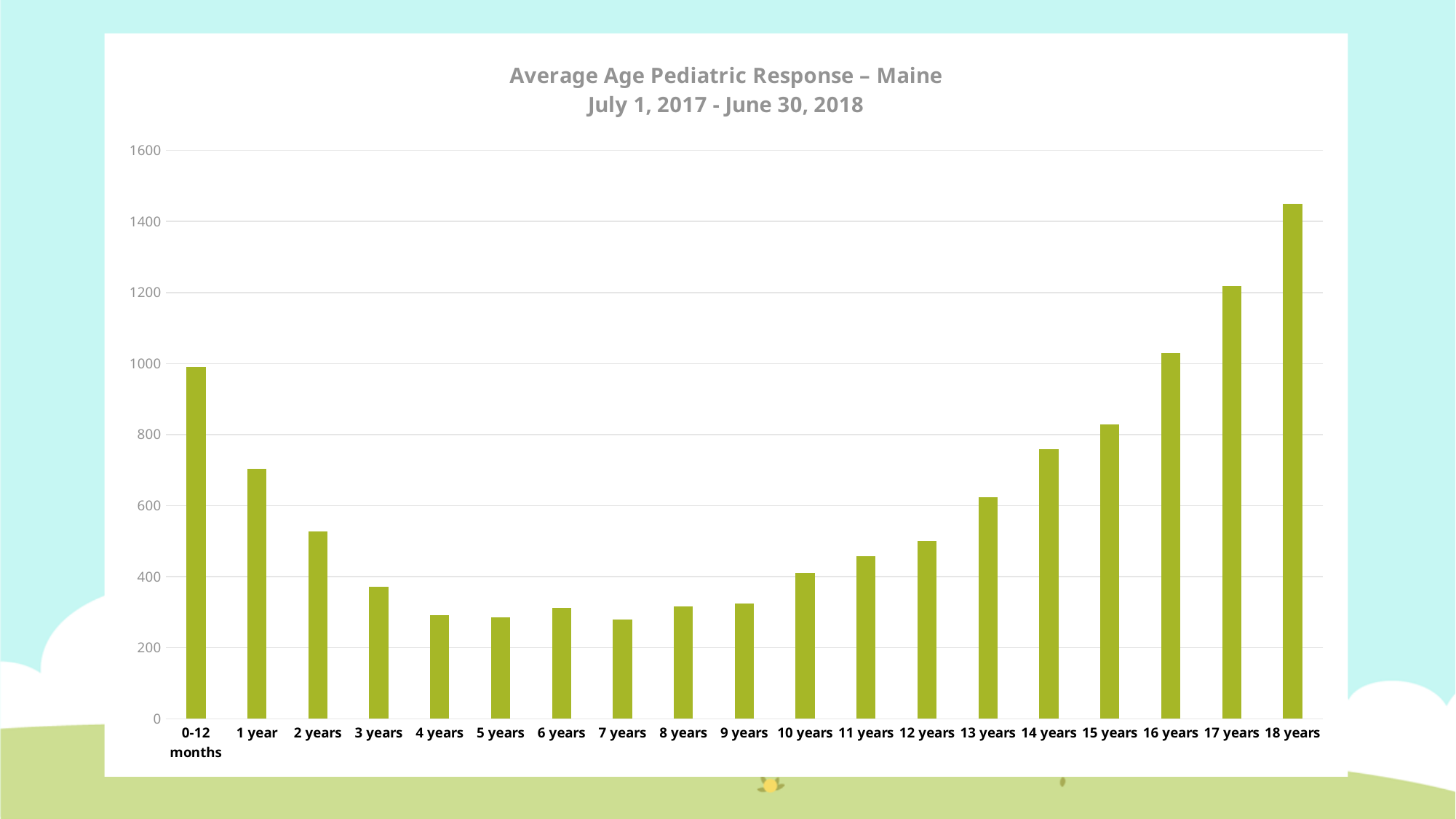
What kind of chart is shown on the slide? bar chart Which age category has the highest value? 18 years Do the values rise or fall from 7 years to 18 years? rise Which is larger, the value for 0-12 months or the value for 1 year? 0-12 months Is the value for 14 years greater or less than 800? less How many age categories are shown on the x axis? 19 What is the title of the chart? Average Age Pediatric Response – Maine July 1, 2017 - June 30, 2018 Is the value for 0-12 months greater or less than 800? greater Is the value for 3 years greater or less than 400? less Which is larger, the value for 16 years or the value for 17 years? 17 years